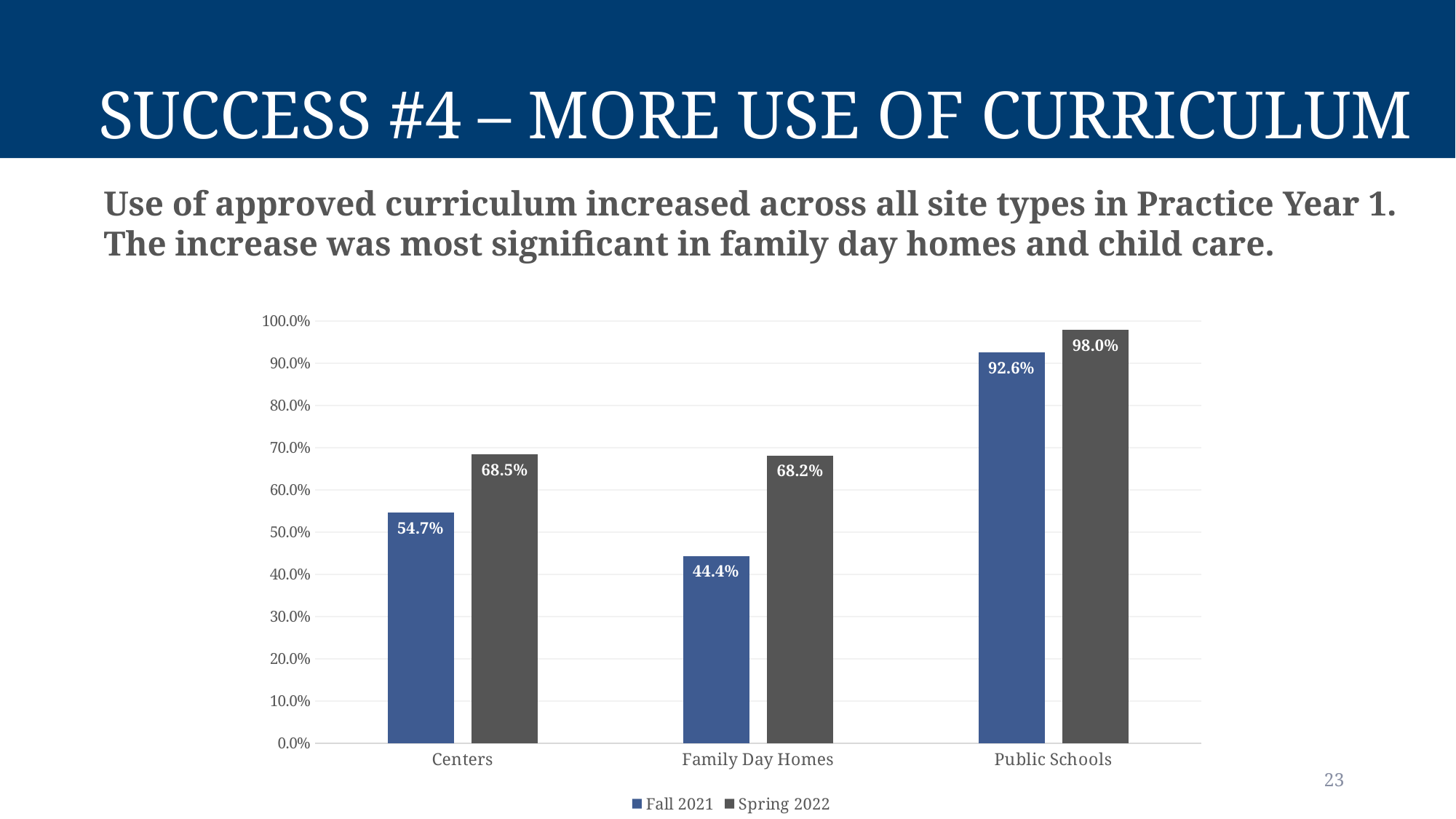
What is the difference between the Spring 2022 and Fall 2021 values for Family Day Homes? 23.8% What is the Fall 2021 value for Centers? 54.7% How many series does the legend list? 2 Which site type has the lowest Fall 2021 value? Family Day Homes Is the Spring 2022 value for Public Schools greater or less than 90.0%? greater What is the Spring 2022 value for Family Day Homes? 68.2% What kind of chart is shown on the slide? Bar chart What is the difference between the Spring 2022 and Fall 2021 values for Centers? 13.8% Which is larger: the Fall 2021 value for Centers or the Fall 2021 value for Family Day Homes? Centers What is the Spring 2022 value for Public Schools? 98.0% How many site types are shown on the x axis? 3 Which site type has the highest Fall 2021 value? Public Schools